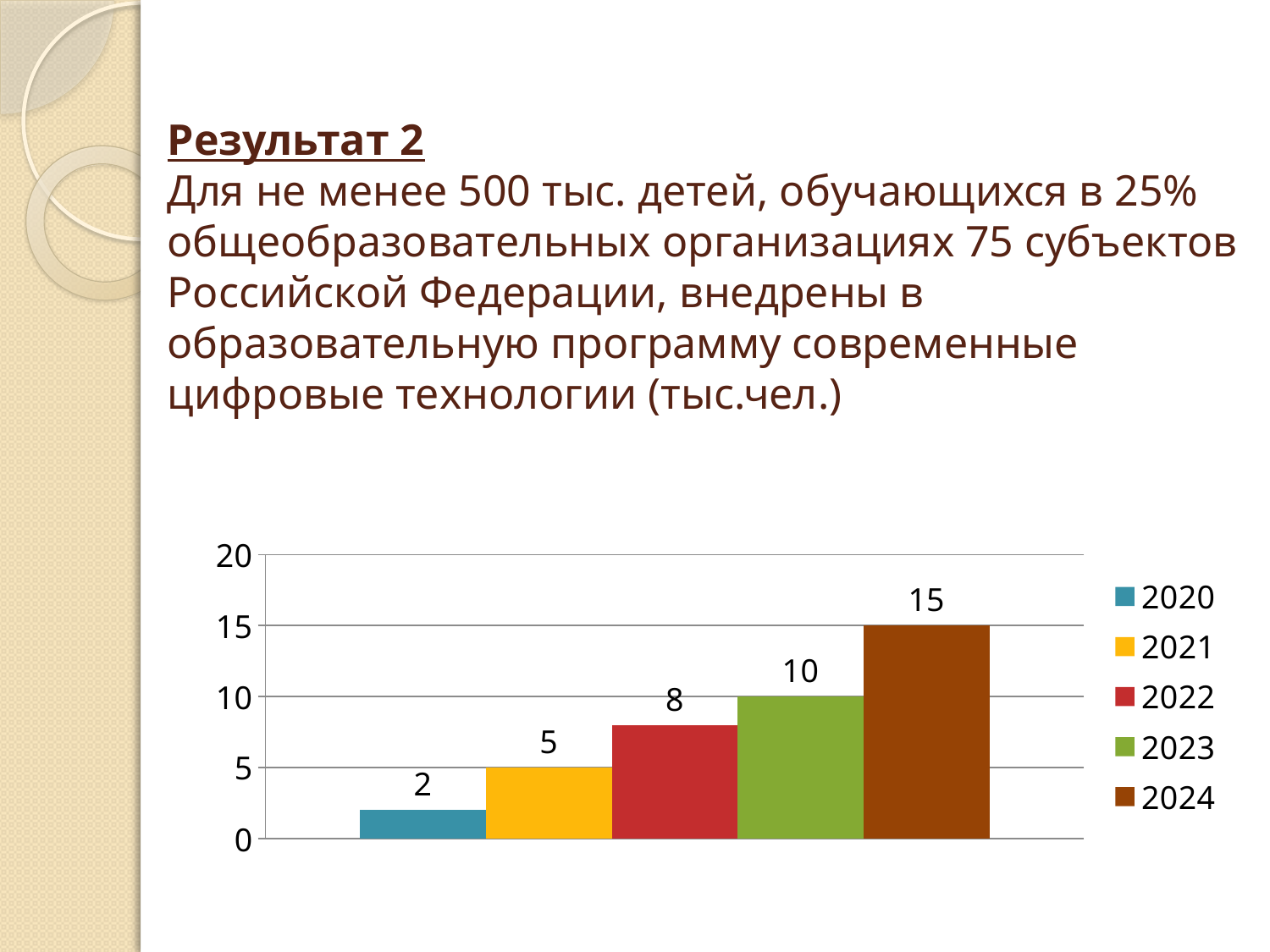
Which year has the highest value? 2024 How many series does the legend list? 5 Is the value for 2024 greater or less than 10? greater Do the values rise or fall from 2020 to 2024? rise What is the value for 2020? 2 What is the difference between the values for 2022 and 2020? 6 Which is larger, the value for 2021 or the value for 2023? 2023 What kind of chart is shown on the slide? bar chart What is the value for 2022? 8 What is the value for 2024? 15 Which year has the lowest value? 2020 What is the difference between the values for 2024 and 2023? 5